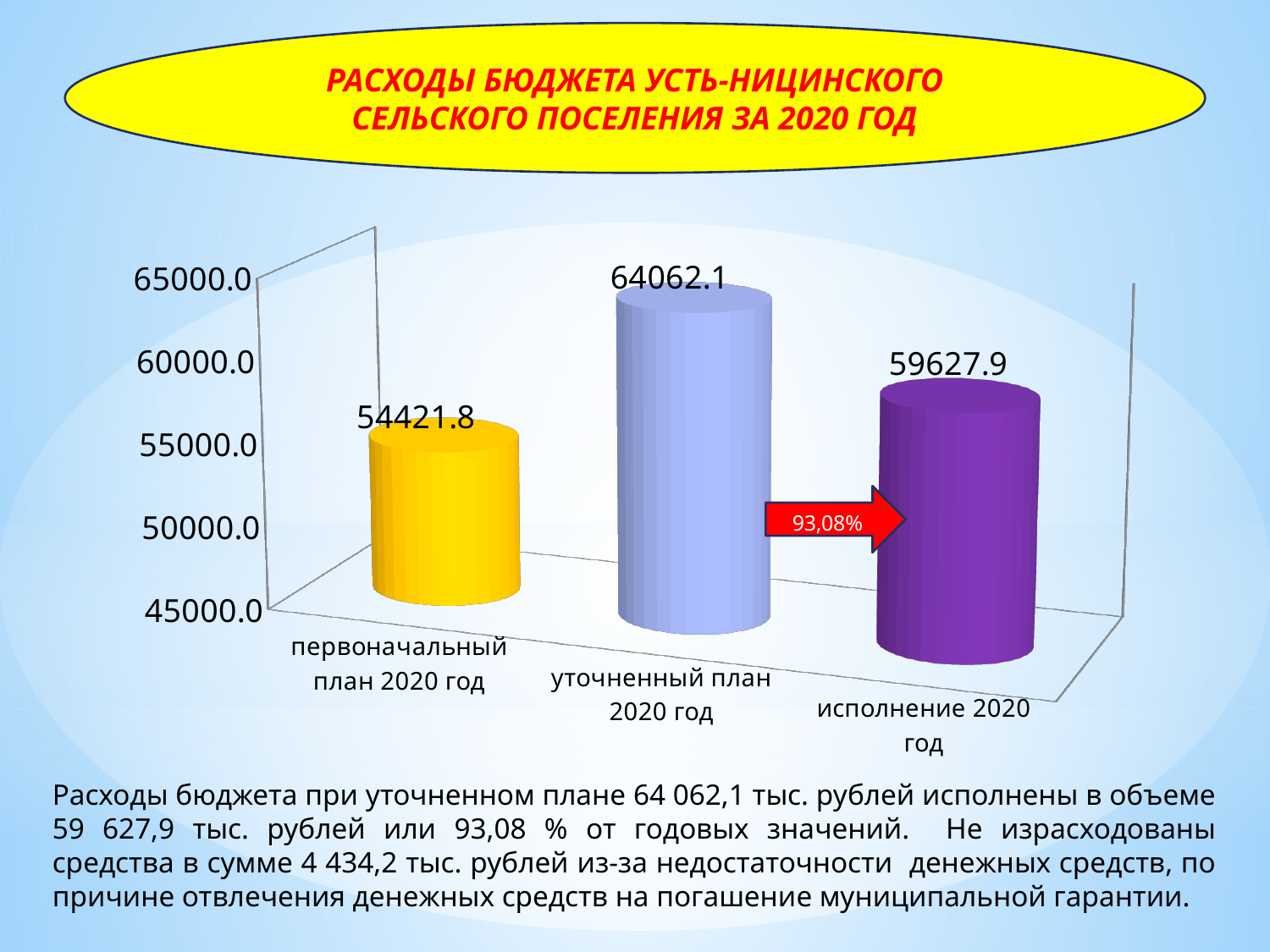
What is the value for «первоначальный план 2020 год»? 54421.8 What kind of chart is shown on the slide? bar chart Is the value for «исполнение 2020 год» greater or less than 60000.0? less What is the difference between «уточненный план 2020 год» and «первоначальный план 2020 год»? 9640.3 What is the value for «исполнение 2020 год»? 59627.9 What is the value for «уточненный план 2020 год»? 64062.1 Which is larger: «исполнение 2020 год» or «первоначальный план 2020 год»? исполнение 2020 год Which category has the lowest value? первоначальный план 2020 год What is the title of the slide? РАСХОДЫ БЮДЖЕТА УСТЬ-НИЦИНСКОГО СЕЛЬСКОГО ПОСЕЛЕНИЯ ЗА 2020 ГОД What is the difference between «уточненный план 2020 год» and «исполнение 2020 год»? 4434.2 How many categories are shown in the chart? 3 Which category has the highest value? уточненный план 2020 год